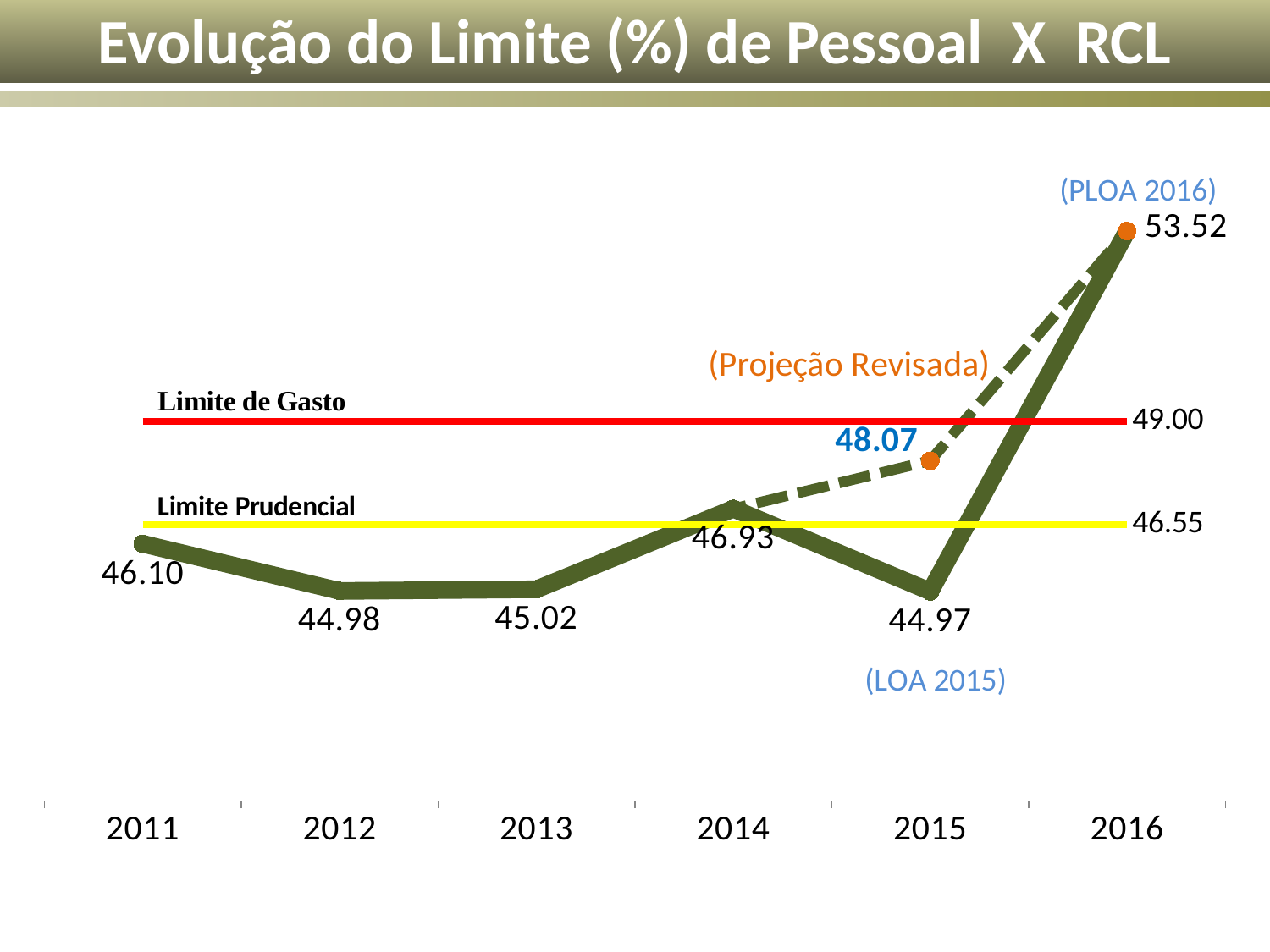
What is the value plotted for 2014? 46.93 What is the value plotted for 2011? 46.10 How many years are shown on the x axis? 6 Which year has the lowest value on the main line? 2015 What value is shown for the Limite Prudencial line? 46.55 Which is larger, the value for 2013 or the value for 2014? 2014 What kind of chart is shown on the slide? Line chart What is the value of the Projeção Revisada point at 2015? 48.07 What value is shown for the Limite de Gasto line? 49.00 What is the value labelled for 2016 (PLOA 2016)? 53.52 Which year has the highest value on the main line? 2016 What is the difference between the 2016 value (53.52) and the Limite de Gasto (49.00)? 4.52